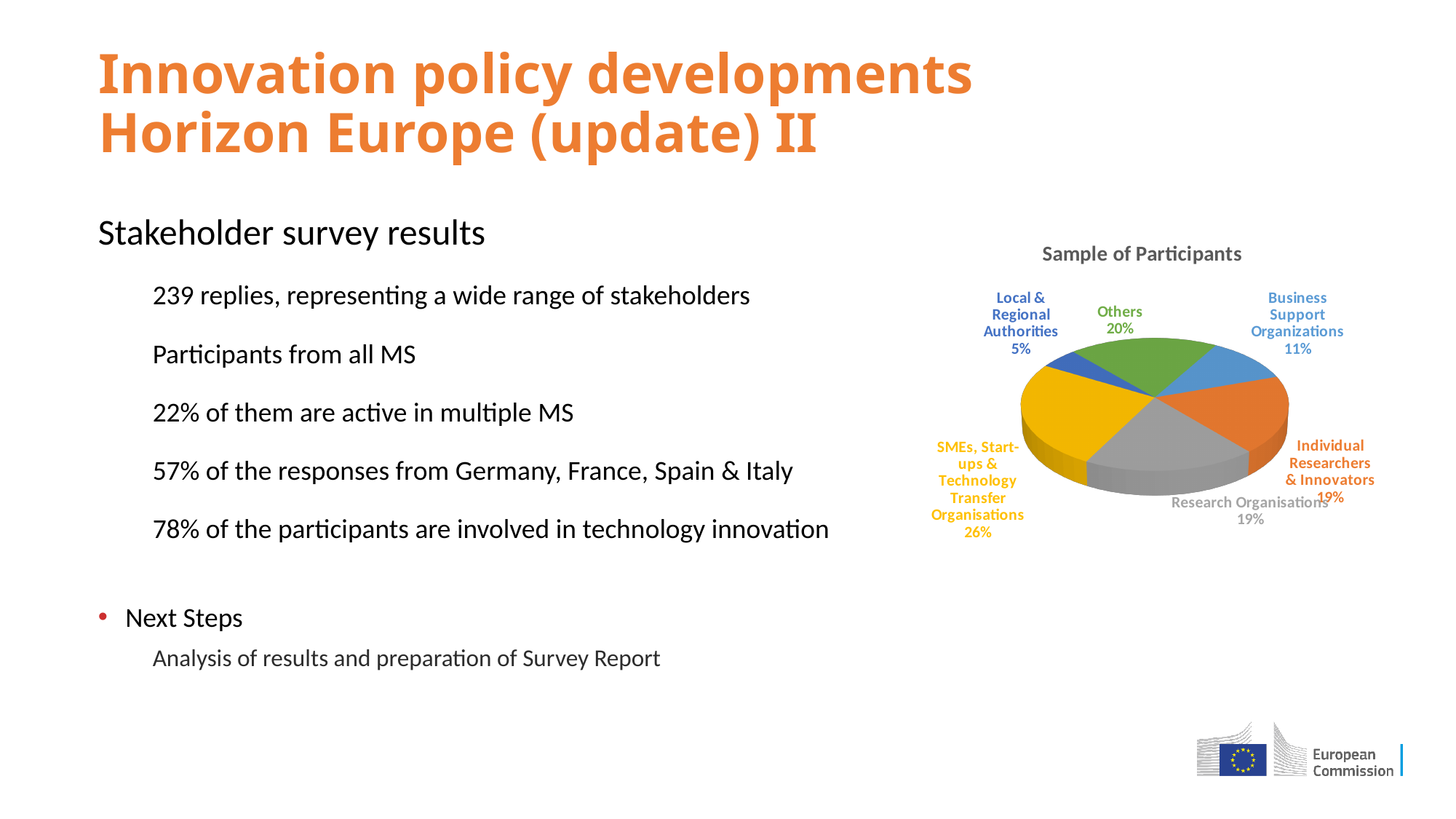
What share of participants are SMEs, Start-ups & Technology Transfer Organisations? 26% What share of participants are Local & Regional Authorities? 5% Which category has the smallest share of participants? Local & Regional Authorities What is the title of the chart? Sample of Participants What colour is the slice for Research Organisations? Grey What kind of chart is shown on the slide? Pie chart How many categories are shown in the pie chart? 6 Which category has the largest share of participants? SMEs, Start-ups & Technology Transfer Organisations What share of participants are Business Support Organizations? 11% What is the difference in percentage points between Others and Business Support Organizations? 9 Which is larger: the share for Others or the share for Individual Researchers & Innovators? Others